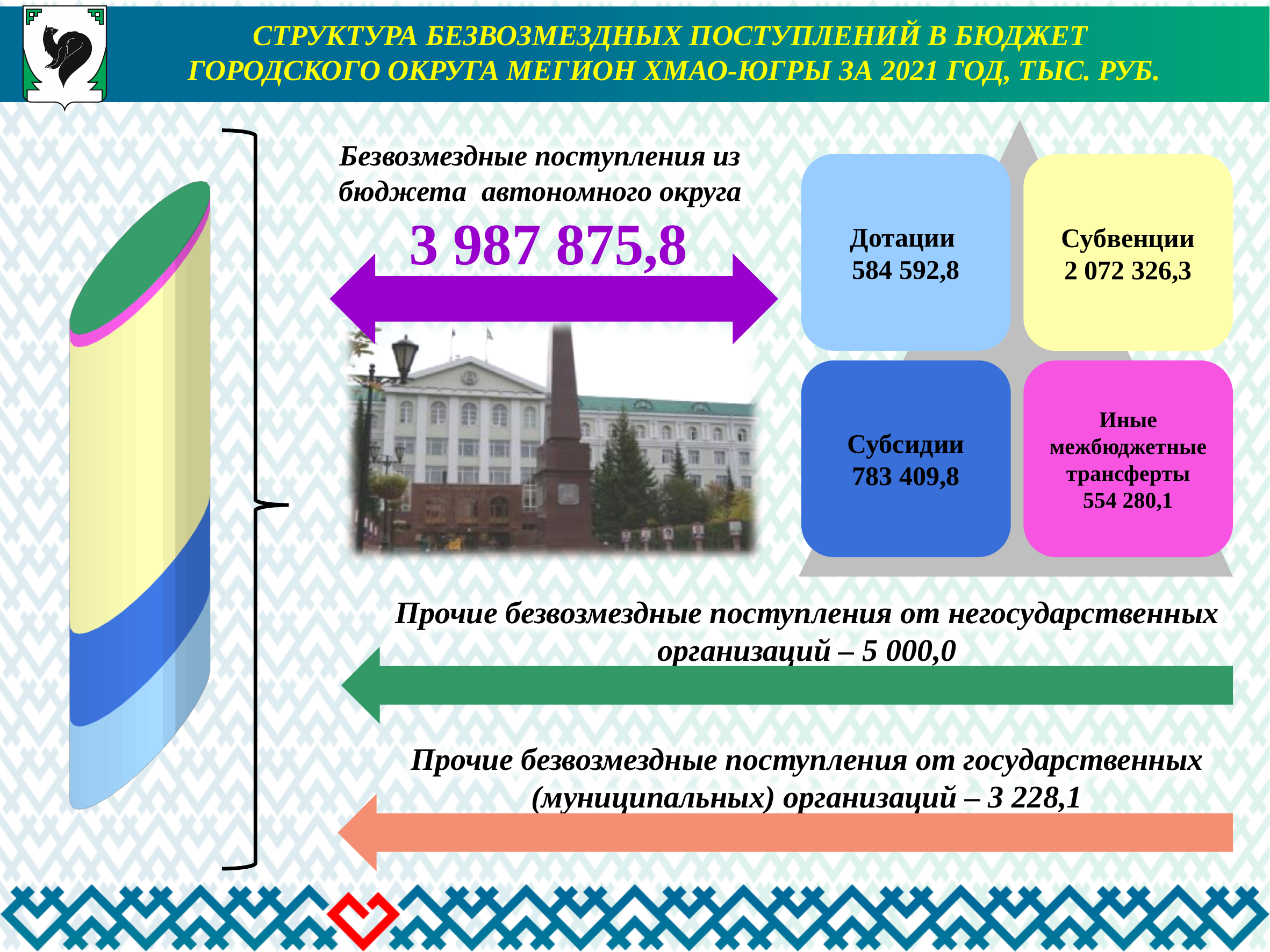
What is the value for Субвенции? 2 072 326,3 What is the value for Прочие безвозмездные поступления от государственных (муниципальных) организаций? 3 228,1 Which of the four categories (Дотации, Субвенции, Субсидии, Иные межбюджетные трансферты) has the lowest value? Иные межбюджетные трансферты What is the value for Прочие безвозмездные поступления от негосударственных организаций? 5 000,0 What is the value for Субсидии? 783 409,8 What is the value for Дотации? 584 592,8 What is the difference between Субвенции and Субсидии? 1 288 916,5 What kind of chart is shown on the left of the slide? bar chart Which is larger, Субсидии or Дотации? Субсидии Which of the four categories (Дотации, Субвенции, Субсидии, Иные межбюджетные трансферты) has the highest value? Субвенции What is the value for Иные межбюджетные трансферты? 554 280,1 What is the total of Безвозмездные поступления из бюджета автономного округа? 3 987 875,8